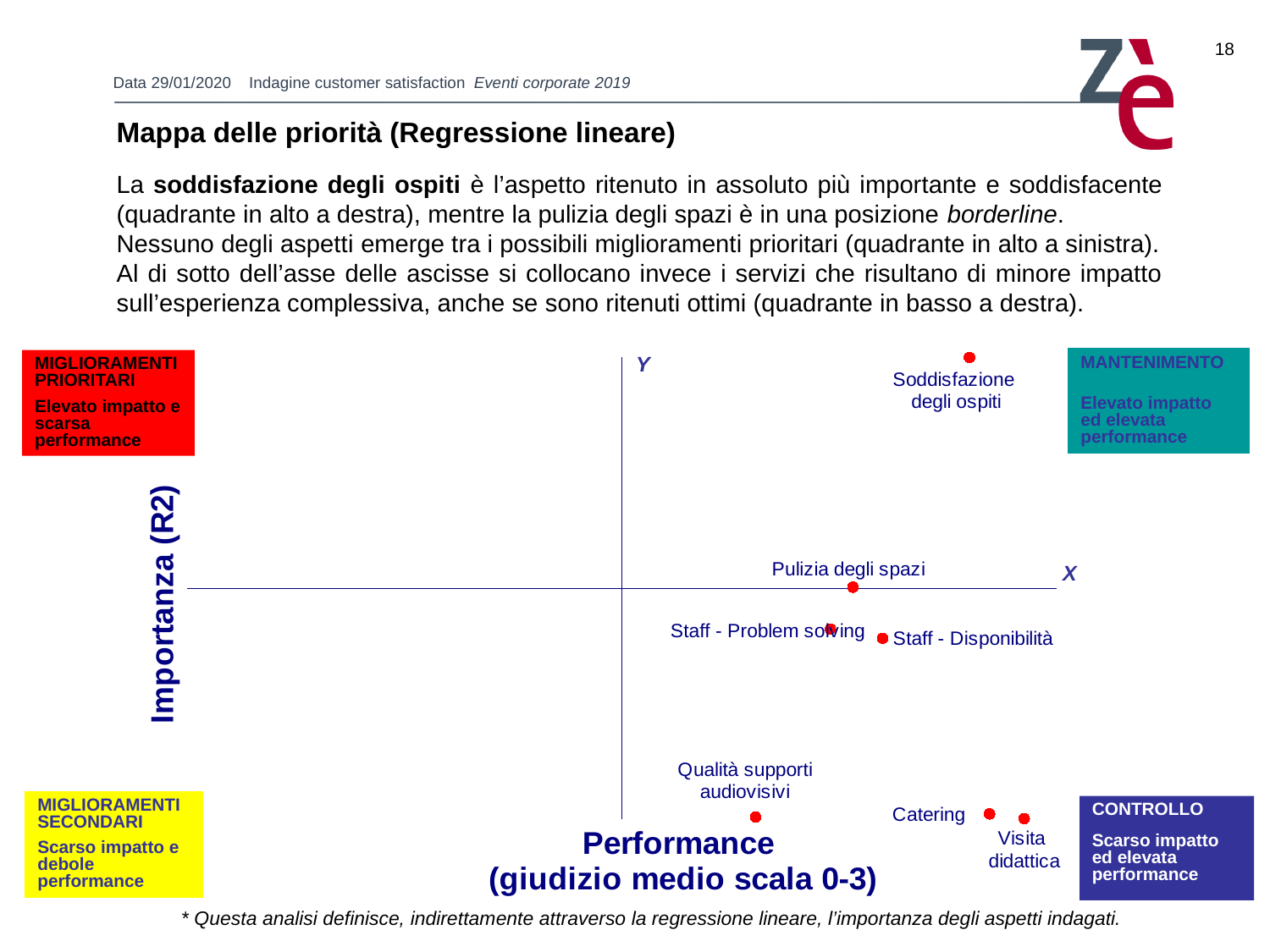
Which aspect lies in the 'Mantenimento' quadrant (top right)? Soddisfazione degli ospiti How many data points are plotted on the priority map? 7 Which has higher importance: Soddisfazione degli ospiti or Catering? Soddisfazione degli ospiti Which aspect has the lowest performance (leftmost position on the X axis)? Qualità supporti audiovisivi What is the label of the horizontal axis of the chart? Performance (giudizio medio scala 0-3) Which has higher performance: Staff - Disponibilità or Qualità supporti audiovisivi? Staff - Disponibilità Which aspect has the highest importance (highest position on the Y axis)? Soddisfazione degli ospiti Which aspect has the highest performance (rightmost position on the X axis)? Visita didattica What kind of chart is shown on the slide? Scatter plot How many aspects are plotted in the 'Miglioramenti prioritari' quadrant (top left)? 0 What is the label of the vertical axis of the chart? Importanza (R2)